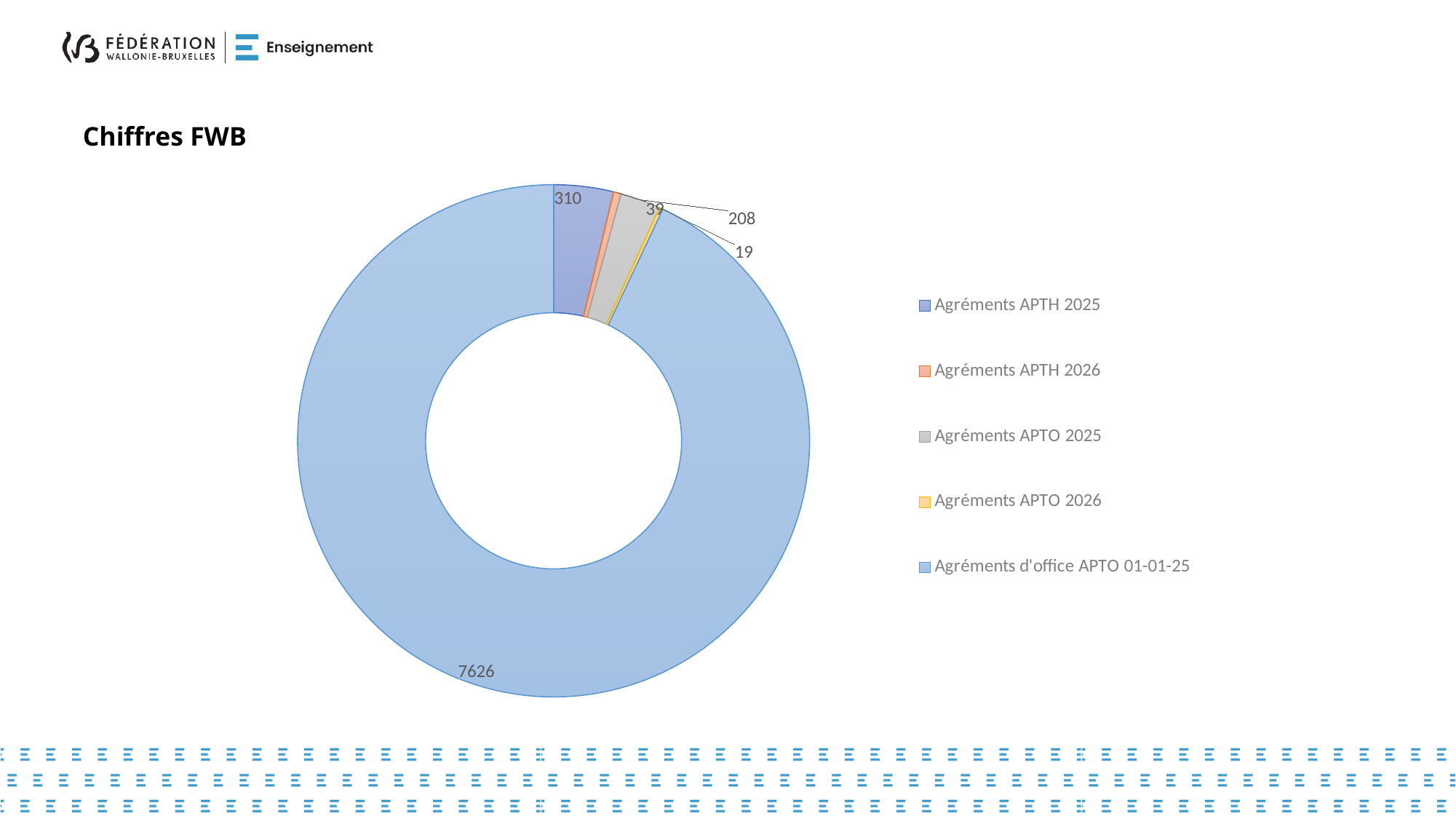
What is the title of the slide above the chart? Chiffres FWB How many categories does the legend list? 5 What is the value for Agréments d'office APTO 01-01-25? 7626 What is the value for Agréments APTH 2026? 39 What is the value for Agréments APTO 2026? 19 What kind of chart is shown on the slide? Doughnut chart Which category has the largest slice? Agréments d'office APTO 01-01-25 What is the value for Agréments APTO 2025? 208 Which is larger, Agréments APTH 2026 or Agréments APTO 2025? Agréments APTO 2025 What is the difference between Agréments APTH 2025 and Agréments APTO 2025? 102 What is the value for Agréments APTH 2025? 310 Which category has the smallest slice? Agréments APTO 2026